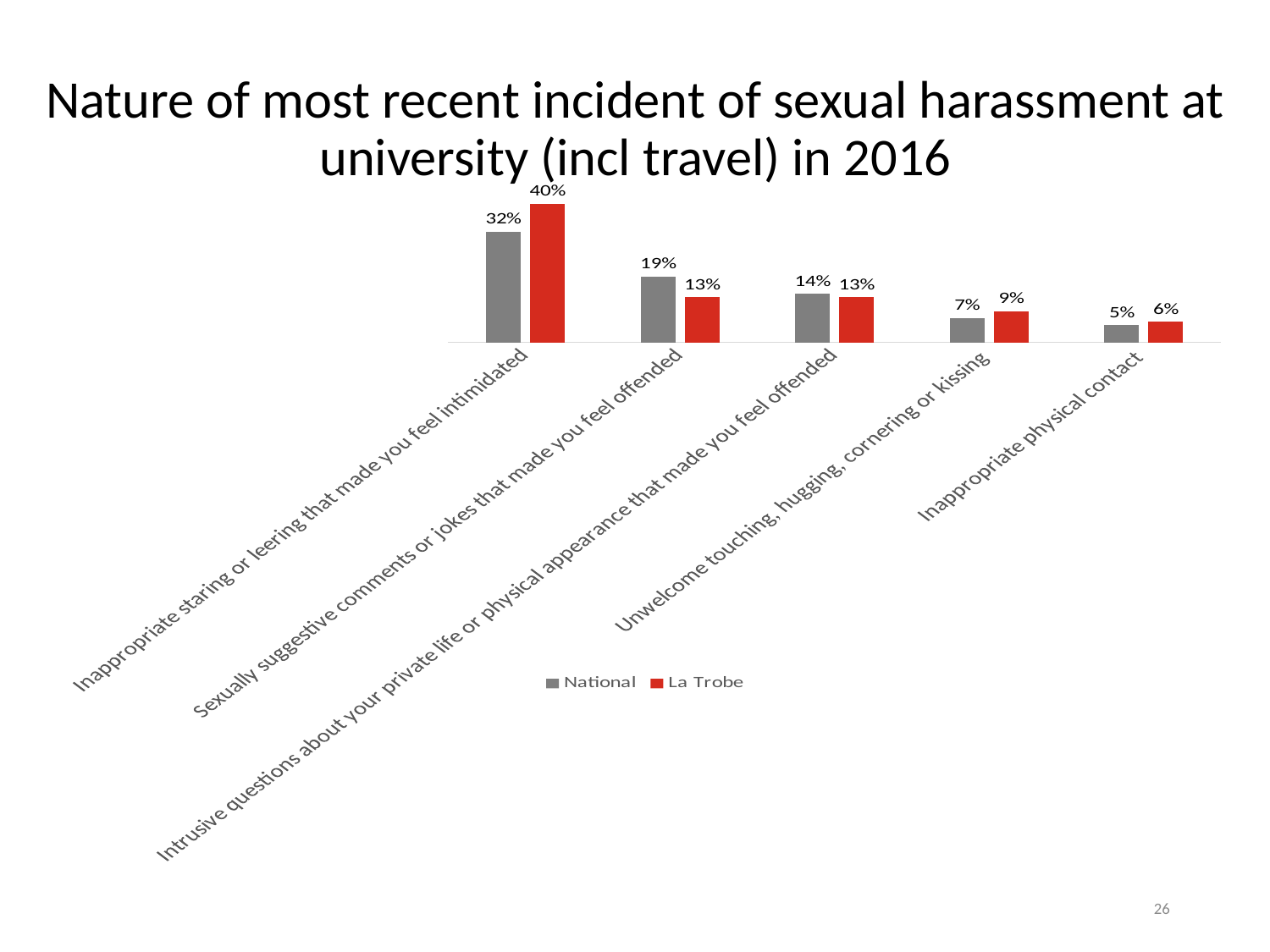
What is the difference between the La Trobe and National values for 'Inappropriate staring or leering that made you feel intimidated'? 8% What is the difference between the National and La Trobe values for 'Sexually suggestive comments or jokes that made you feel offended'? 6% What is the La Trobe value for 'Unwelcome touching, hugging, cornering or kissing'? 9% How many categories are shown on the x axis? 5 What is the National value for 'Sexually suggestive comments or jokes that made you feel offended'? 19% Which category has the highest La Trobe value? Inappropriate staring or leering that made you feel intimidated What is the La Trobe value for 'Inappropriate staring or leering that made you feel intimidated'? 40% What kind of chart is shown on the slide? Bar chart What is the National value for 'Inappropriate staring or leering that made you feel intimidated'? 32% How many series does the legend list? 2 Which category has the lowest National value? Inappropriate physical contact For 'Unwelcome touching, hugging, cornering or kissing', which is larger: the National value or the La Trobe value? La Trobe